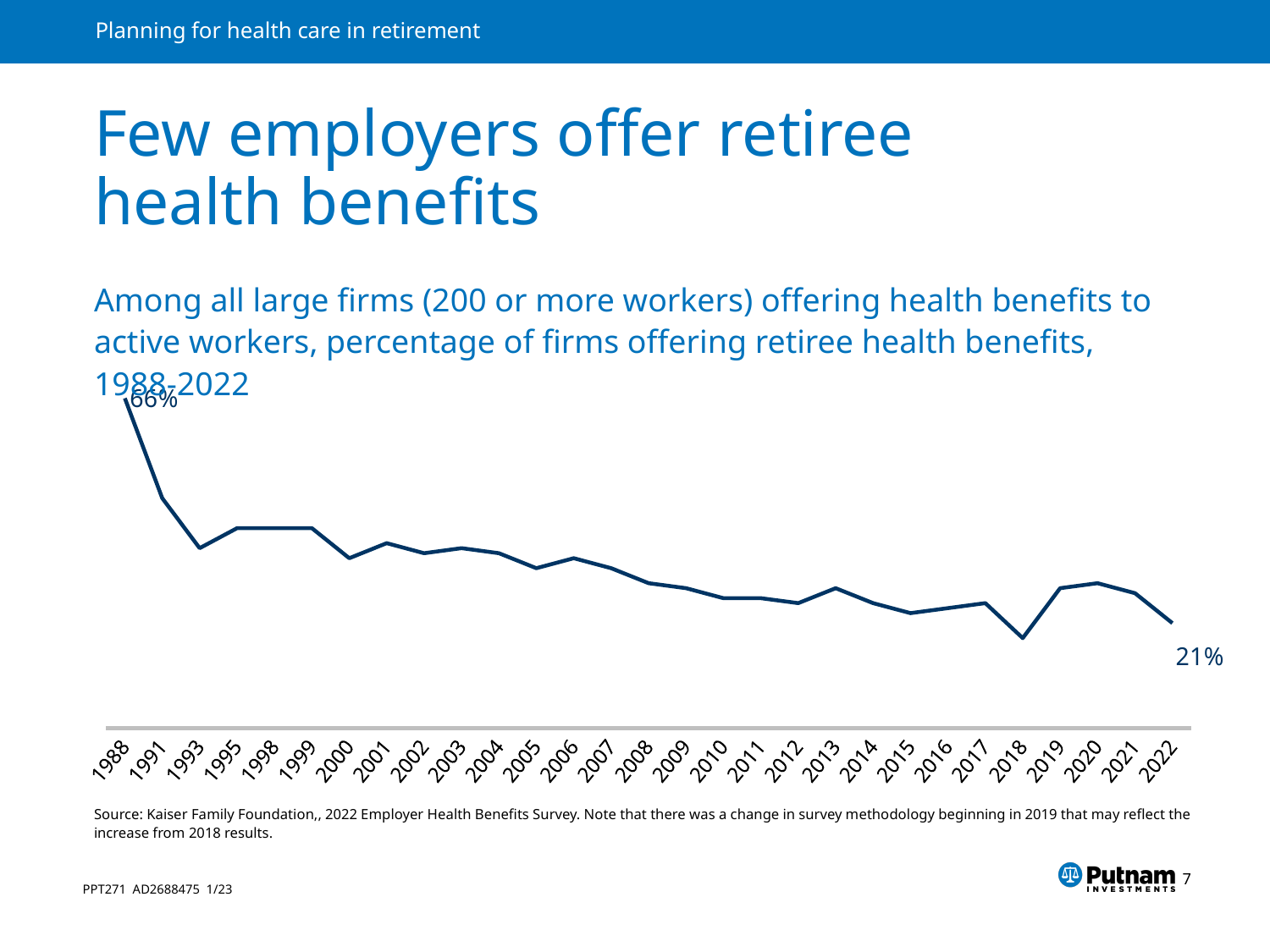
What is the value for 1988? 66% What is the value for 2022? 21% Which year has the highest value? 1988 What is the first year shown on the x axis? 1988 Which is larger, the value for 2017 or the value for 2018? 2017 Which is larger, the value for 1988 or the value for 2022? 1988 By how many percentage points did the value fall from 1988 to 2022? 45 percentage points Do the values generally rise or fall from 1988 to 2022? Fall Which is larger, the value for 1993 or the value for 1995? 1995 What kind of chart is shown on the slide? Line chart What is the title of the slide containing the chart? Few employers offer retiree health benefits How many years are shown on the x axis? 29